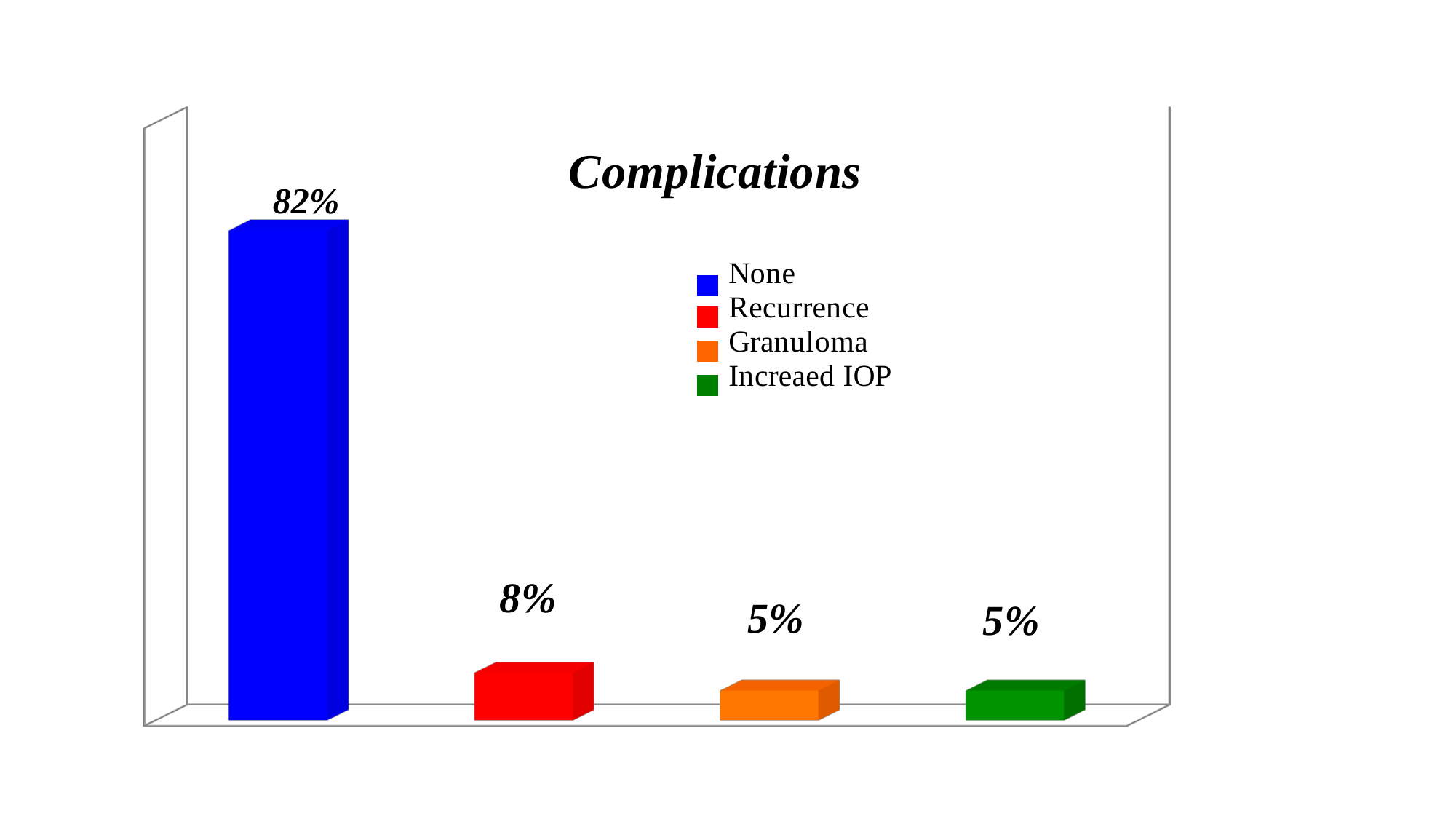
What is the difference between the values for None and Recurrence in the Complications chart? 74% What is the value for Granuloma in the Complications chart? 5% What is the difference between the values for Recurrence and Granuloma in the Complications chart? 3% How many entries does the legend of the Complications chart list? 4 What colour is the bar for Granuloma in the Complications chart? Orange Which is larger in the Complications chart, the value for Recurrence or the value for Granuloma? Recurrence What is the value for Recurrence in the Complications chart? 8% What kind of chart is shown on the slide? Bar chart How many bars are plotted in the Complications chart? 4 What is the value for None in the Complications chart? 82% Which category has the highest value in the Complications chart? None What is the value for Increaed IOP in the Complications chart? 5%